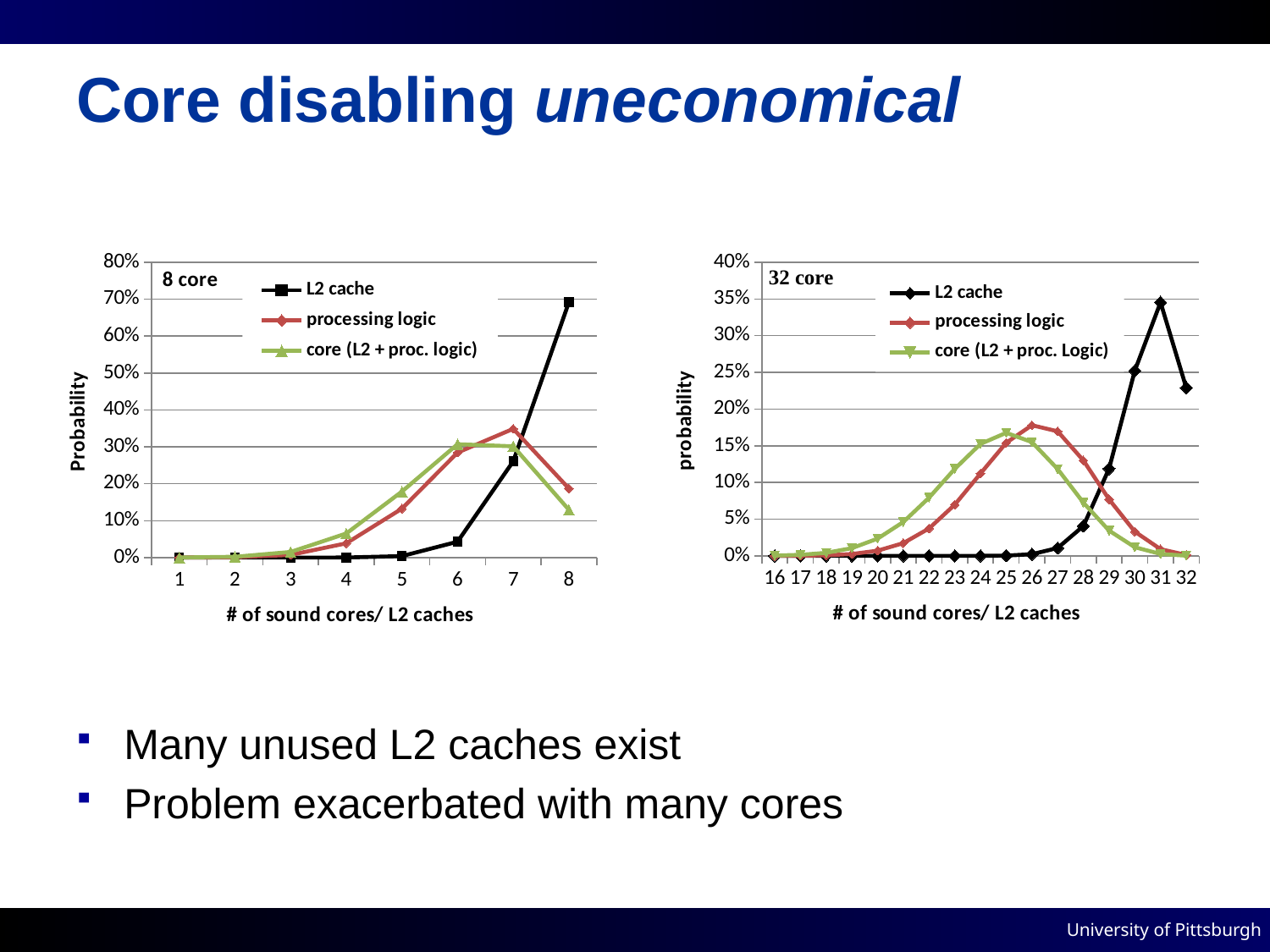
In the 8 core chart, which series has the larger value at 8 sound cores, L2 cache or core (L2 + proc. logic)? L2 cache How many x-axis points are plotted in the 32 core chart? 17 In the 8 core chart, is the L2 cache value at 8 sound cores greater or less than 60%? greater In the 32 core chart, is the L2 cache value at 32 sound cores greater or less than 25%? less In the 32 core chart, at which number of sound cores does the L2 cache series reach its highest value? 31 What kind of chart is the 8 core chart? line chart How many x-axis points are plotted in the 8 core chart? 8 In the 32 core chart, is the processing logic value at 26 sound cores greater or less than 15%? greater How many series does the legend of the 32 core chart list? 3 In the 8 core chart, at which number of sound cores does the L2 cache series reach its highest value? 8 What is the x-axis label of the 32 core chart? # of sound cores/ L2 caches